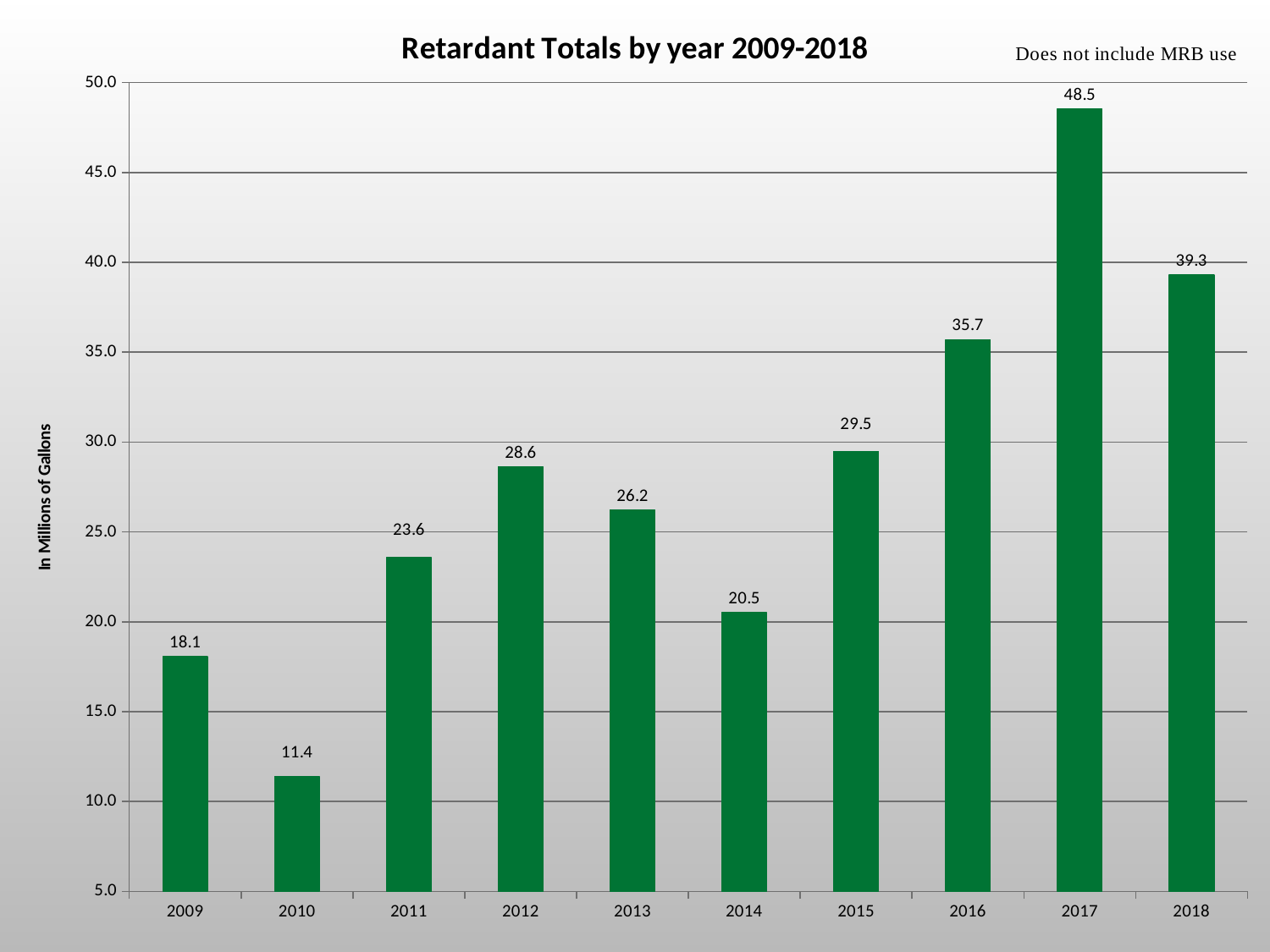
Which year has the highest retardant total? 2017 What is the retardant total for 2010? 11.4 Which year has a larger retardant total, 2015 or 2016? 2016 What is the difference between the retardant totals for 2017 and 2018? 9.2 What kind of chart is shown on the slide? bar chart What is the label on the vertical axis of the chart? In Millions of Gallons What is the difference between the retardant totals for 2012 and 2013? 2.4 What is the retardant total for 2017? 48.5 Which year has the lowest retardant total? 2010 What is the retardant total for 2014? 20.5 How many years are shown on the chart? 10 Is the value for 2011 greater or less than 25.0? less